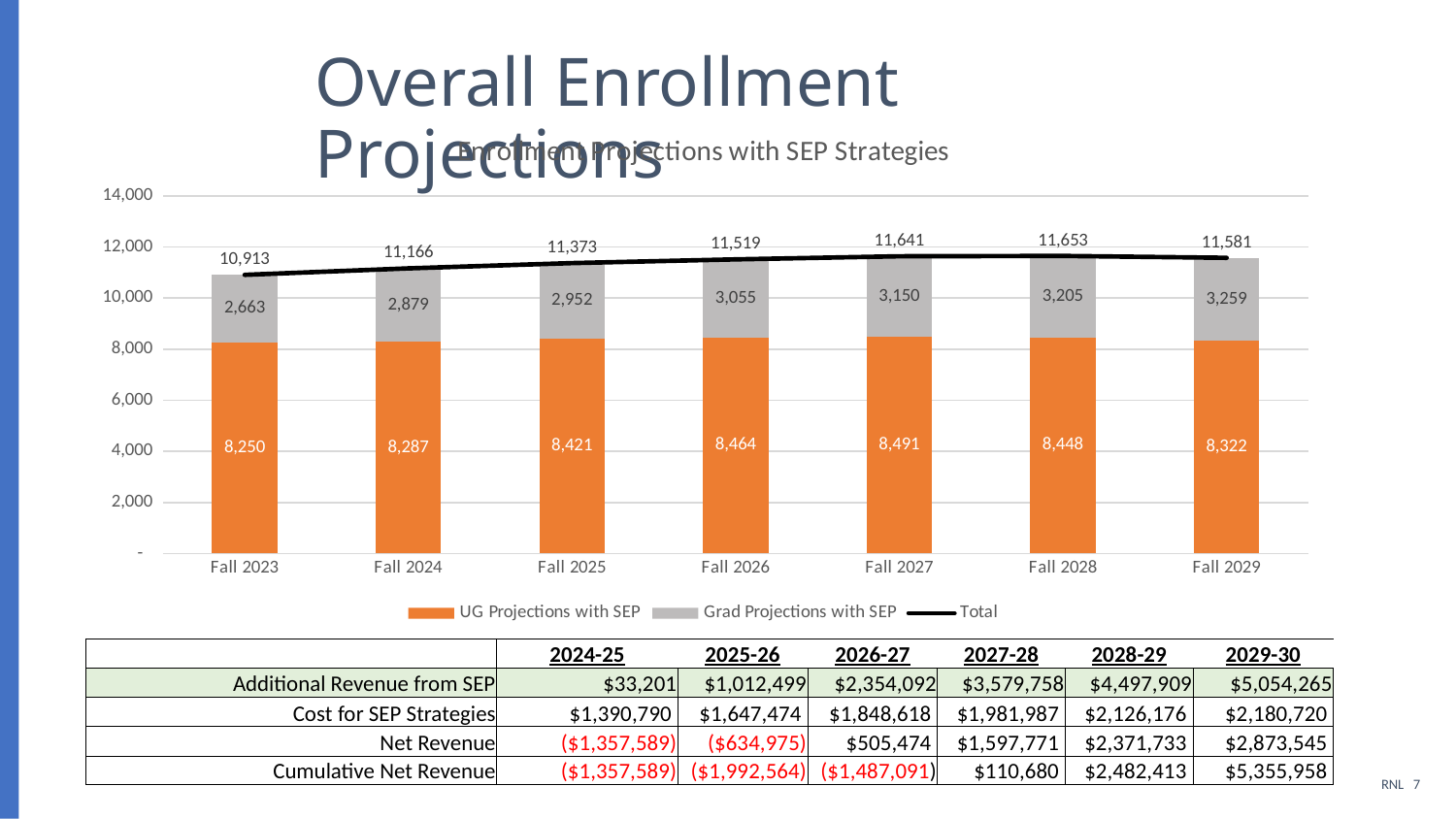
What is the Total value shown for Fall 2023? 10,913 What is the Grad Projections with SEP value for Fall 2028? 3,205 What is the UG Projections with SEP value for Fall 2025? 8,421 What kind of chart is used to show the enrollment projections? Stacked bar chart with a line What is the difference between the Grad Projections with SEP values for Fall 2029 and Fall 2023? 596 Which year has the highest Total enrollment projection? Fall 2028 Which is larger, the UG Projections with SEP value for Fall 2027 or for Fall 2029? Fall 2027 Which colour represents UG Projections with SEP in the chart? Orange How many years (categories) are shown on the x axis of the chart? 7 How many series does the chart legend list? 3 Which year has the lowest Grad Projections with SEP value? Fall 2023 Does the Grad Projections with SEP value rise or fall from Fall 2023 to Fall 2029? Rise